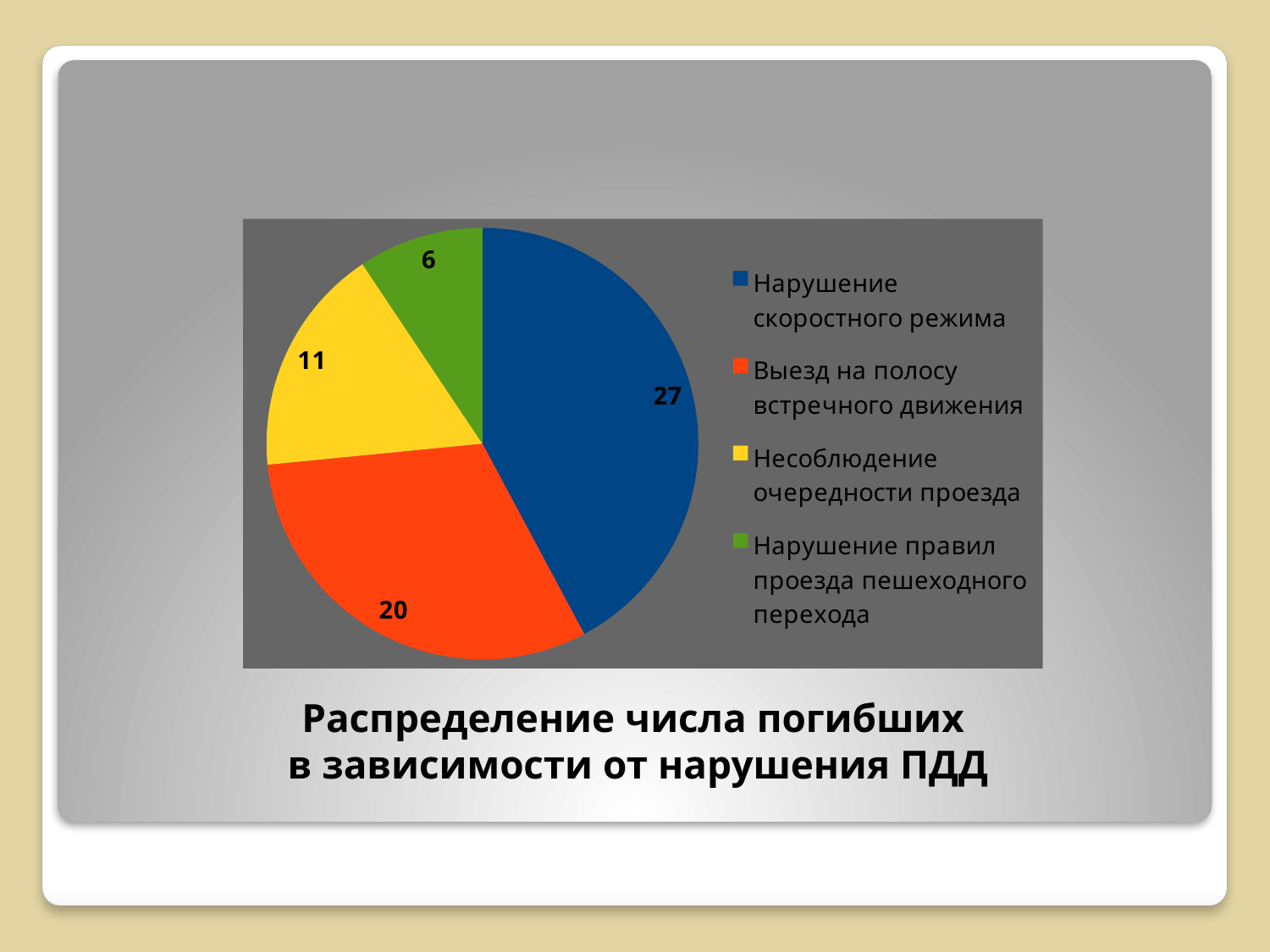
Which category has the smallest slice of the pie? Нарушение правил проезда пешеходного перехода Which category has the largest slice of the pie? Нарушение скоростного режима Which is larger: the value for "Несоблюдение очередности проезда" or the value for "Нарушение правил проезда пешеходного перехода"? Несоблюдение очередности проезда How many slices does the pie chart have? 4 What is the difference between the values for "Нарушение скоростного режима" and "Выезд на полосу встречного движения"? 7 What is the value for "Выезд на полосу встречного движения"? 20 What is the value for "Несоблюдение очередности проезда"? 11 What is the title of the chart shown on the slide? Распределение числа погибших в зависимости от нарушения ПДД What is the value for "Нарушение скоростного режима"? 27 What is the value for "Нарушение правил проезда пешеходного перехода"? 6 What type of chart is shown on the slide? Pie chart What is the total of all the slice values in the pie chart? 64